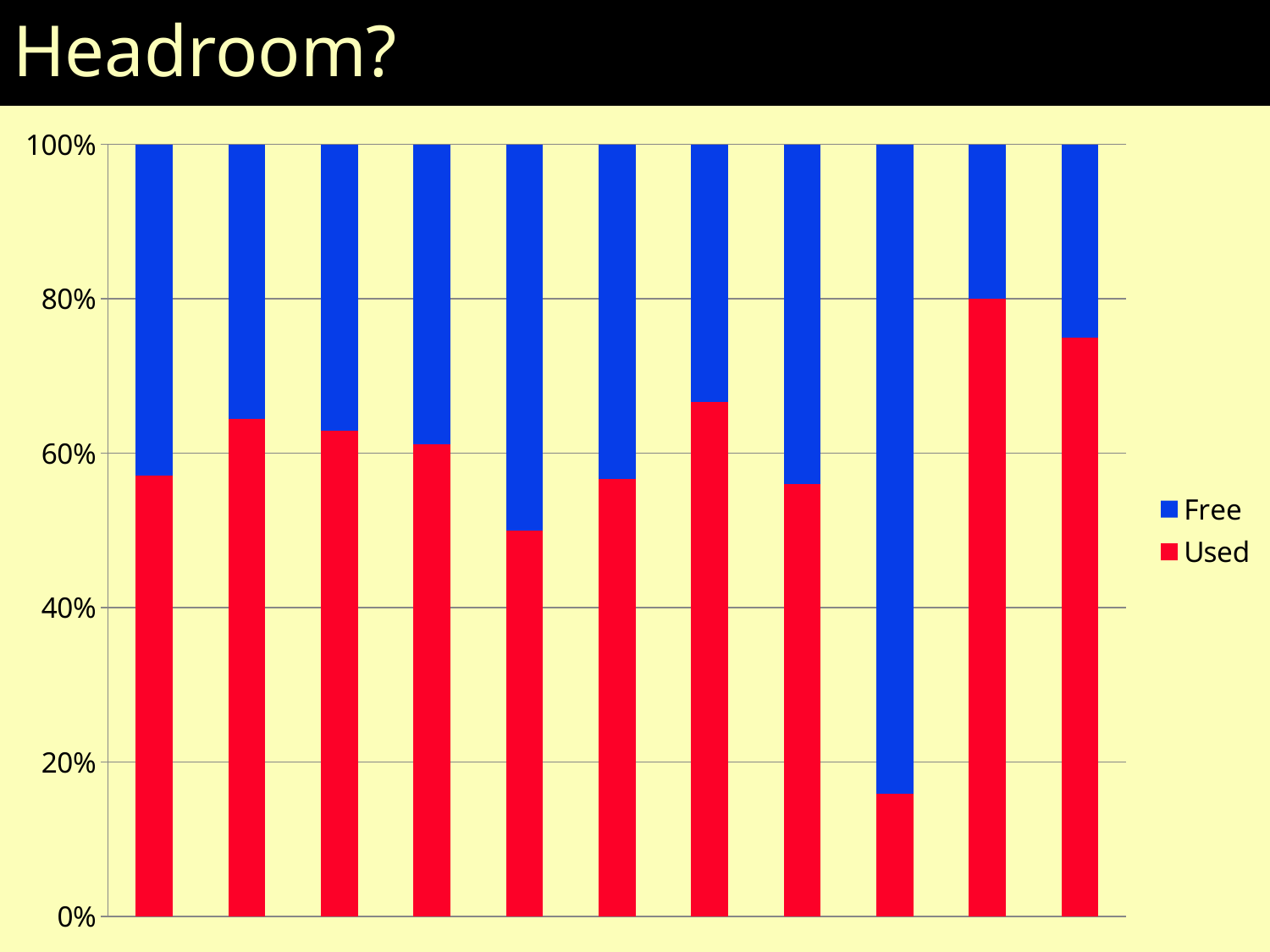
What are the two series named in the legend? Free and Used Is the Used value for the tenth bar from the left greater or less than 60%? greater Is the Used value for the ninth bar from the left greater or less than 20%? less Which colour represents the Used series? red Which has the larger Used share, the ninth bar from the left or the tenth bar from the left? the tenth bar from the left Which bar has the largest Used share? the tenth bar from the left What kind of chart is shown on the slide? bar chart Which bar has the largest Free share? the ninth bar from the left Is the Used value for the first bar from the left greater or less than 60%? less How many stacked bars are plotted in the chart? 11 Which bar has the smallest Used share? the ninth bar from the left How many series does the legend list? 2